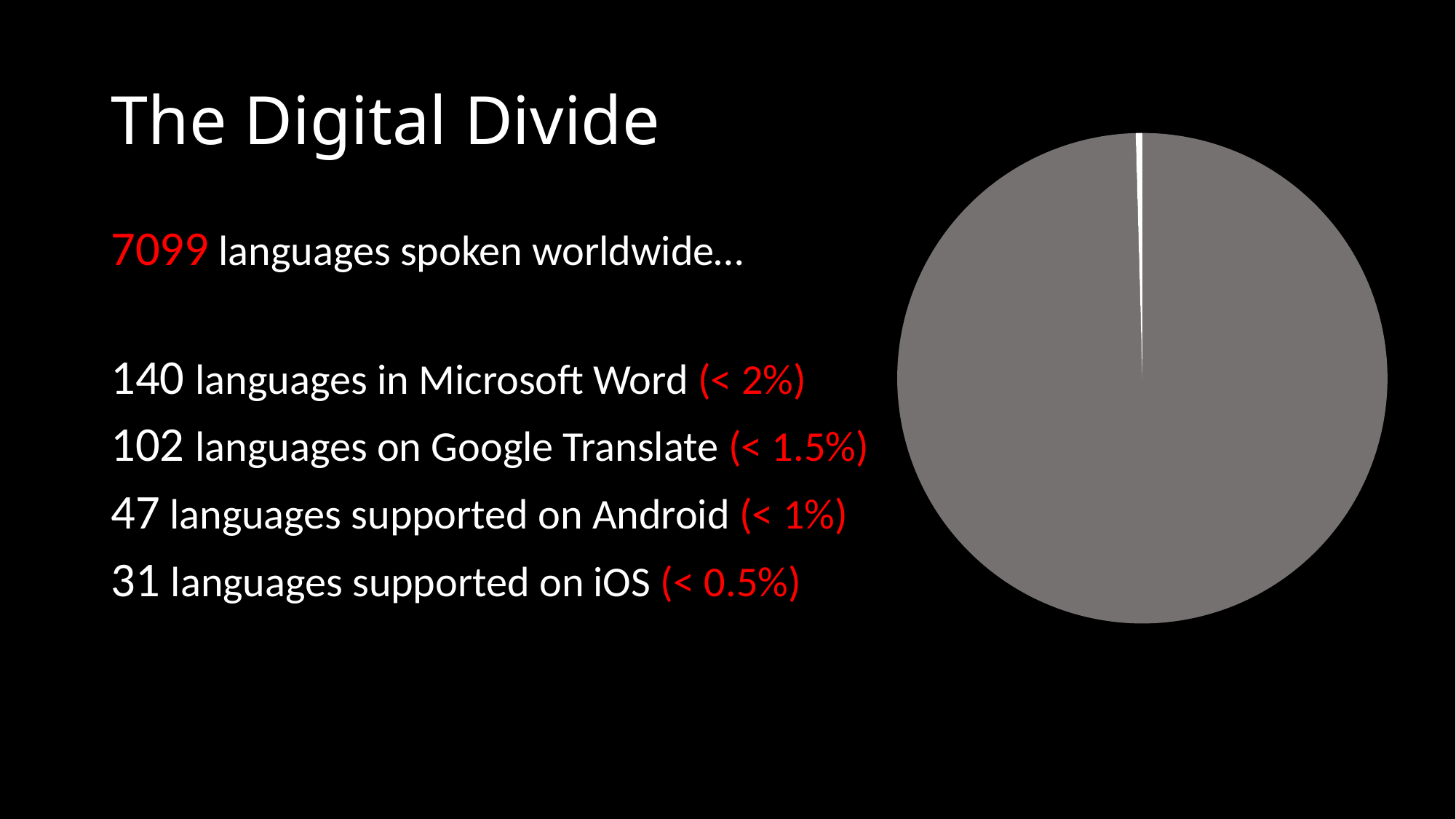
What kind of chart is shown on the slide? pie chart How many slices does the pie chart on the slide have? 2 Which slice of the pie chart is larger, the grey slice or the white slice? the grey slice What colour is the largest slice of the pie chart? grey Does the pie chart on the slide have a legend? No What colour is the smallest slice of the pie chart? white